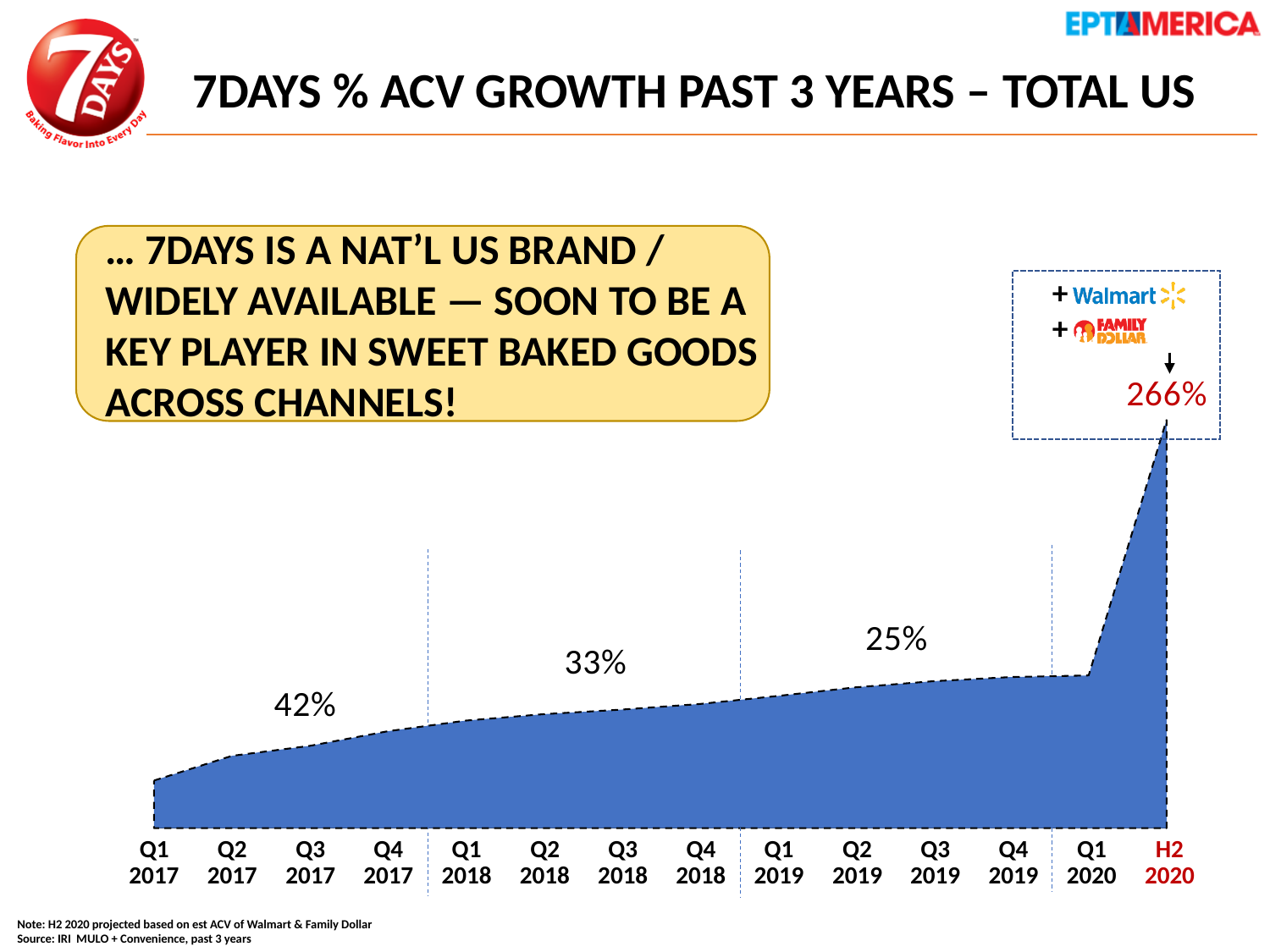
How many periods are labelled along the x axis of the chart? 14 What is the title of the chart on the slide? 7DAYS % ACV GROWTH PAST 3 YEARS – TOTAL US What growth percentage is labelled over the 2019 quarters of the chart? 25% Which labelled year shows the lowest growth percentage on the chart? 2019 What is the difference between the 2017 growth label (42%) and the 2018 growth label (33%)? 9 percentage points Which is larger, the growth label for 2018 or the growth label for 2019? 2018 What kind of chart is shown on the slide? Area chart Does the plotted area rise or fall from Q1 2017 to H2 2020? Rise What growth percentage is labelled over the 2017 quarters of the chart? 42% What growth percentage is labelled over the 2018 quarters of the chart? 33% What growth percentage is labelled at the H2 2020 point of the chart? 266% Which labelled period shows the highest growth percentage on the chart? H2 2020